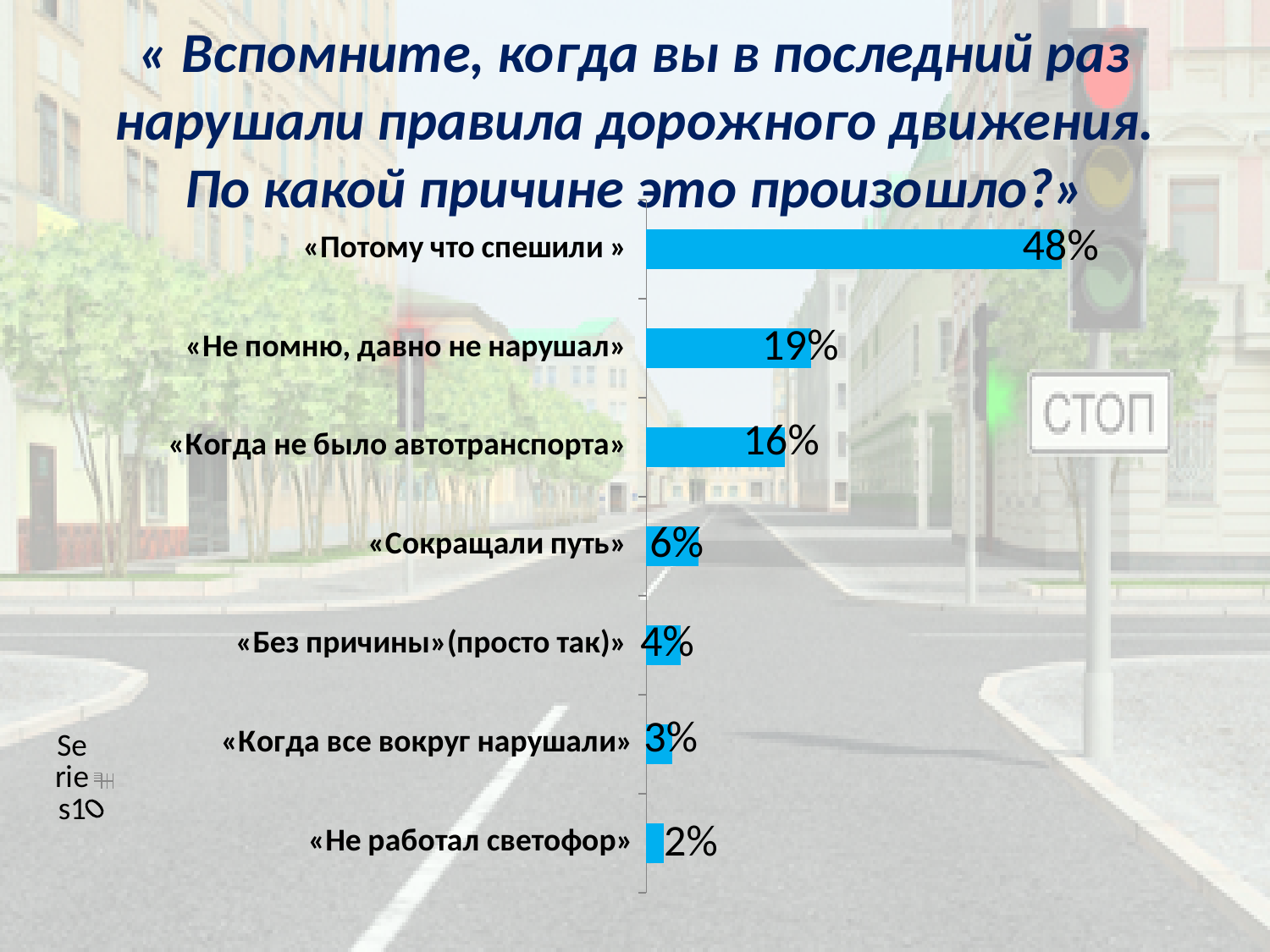
What type of chart is shown on the slide? bar chart What is the value for «Не работал светофор»? 2% Which category has the highest value? «Потому что спешили» How many categories are shown in the chart? 7 What is the value for «Не помню, давно не нарушал»? 19% Which category has the lowest value? «Не работал светофор» What is the value for «Когда не было автотранспорта»? 16% Do the values rise or fall going from the top bar to the bottom bar? fall What is the difference between the values for «Потому что спешили» and «Не помню, давно не нарушал»? 29% What is the value for «Потому что спешили»? 48% What is the value for «Сокращали путь»? 6% Which is larger: the value for «Без причины»(просто так)» or the value for «Когда все вокруг нарушали»? «Без причины»(просто так)»